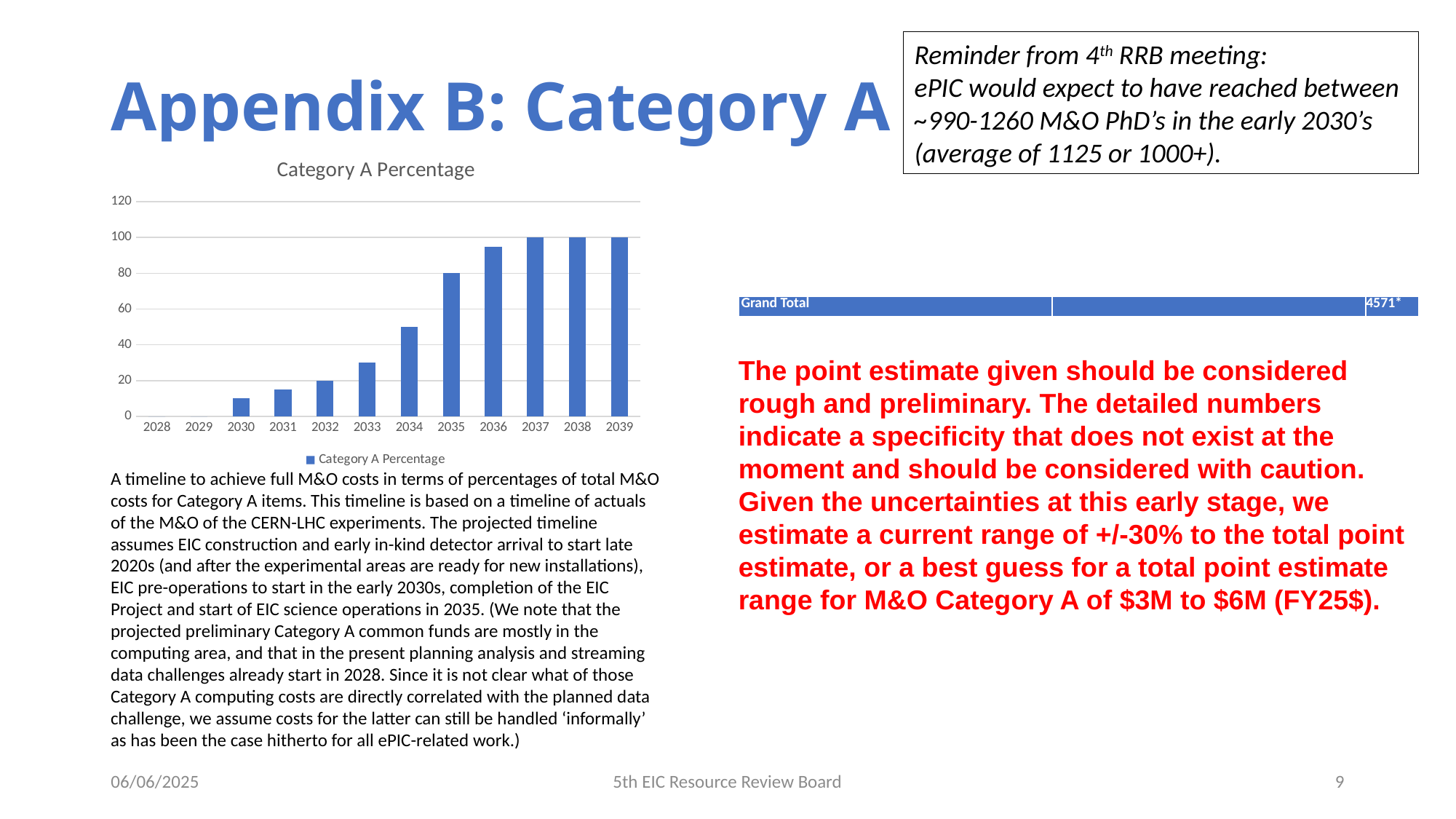
Which year has the larger value, 2033 or 2036? 2036 How many series does the chart legend list? 1 What is the Category A Percentage value for 2037? 100 Is the value for 2034 greater or less than 40? greater What is the title of the chart? Category A Percentage Do the values rise or fall from 2030 to 2037? rise What type of chart is shown on the slide? bar chart How many years are shown on the x axis of the chart? 12 Is the value for 2036 greater or less than 80? greater Is the value for 2030 greater or less than 20? less What is the Category A Percentage value for 2032? 20 What is the Category A Percentage value for 2035? 80